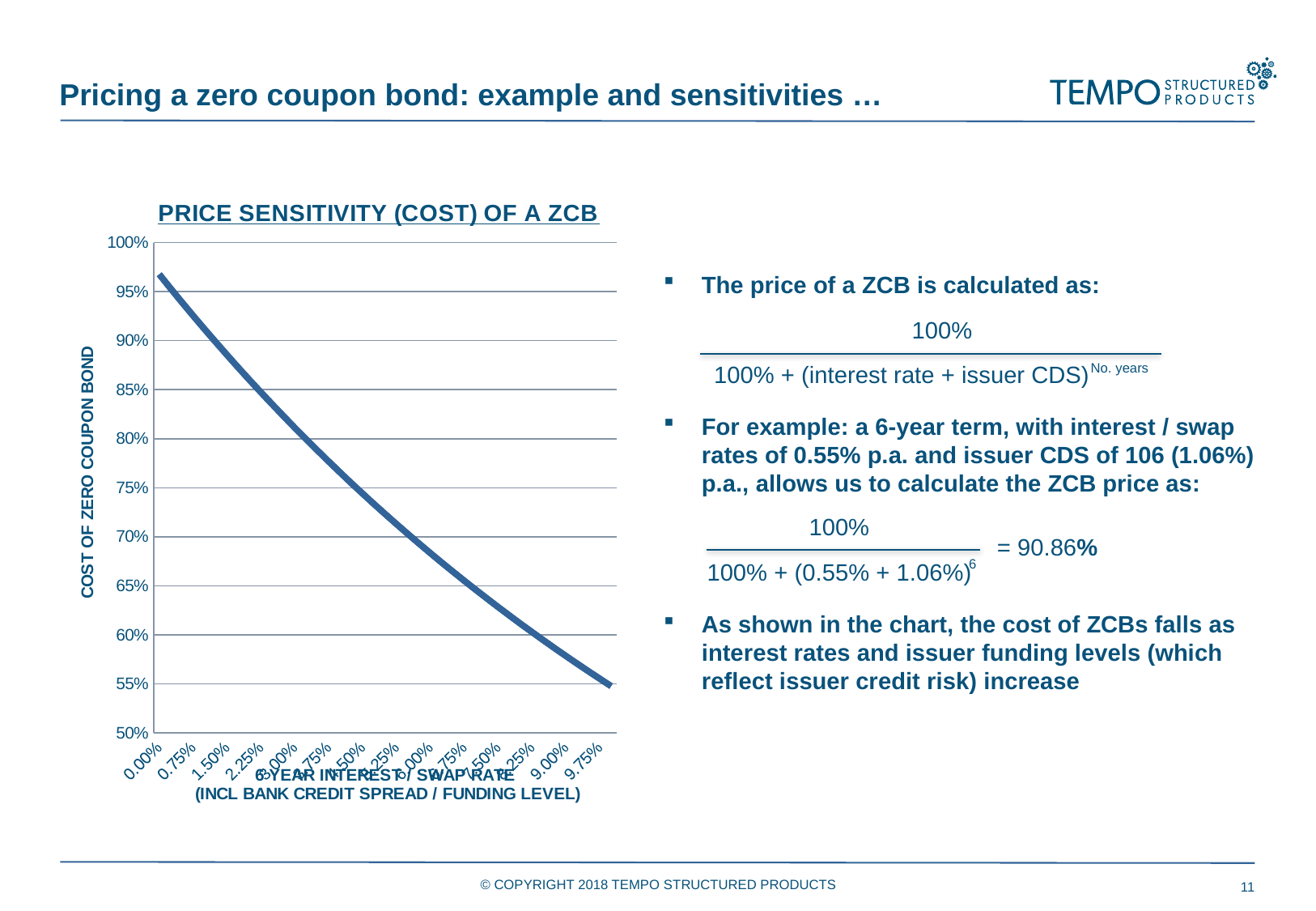
Is the cost of the zero coupon bond at a 9.75% interest / swap rate greater or less than 60%? less Is the cost of the zero coupon bond at a 2.25% interest / swap rate greater or less than 80%? greater What is the label of the vertical axis of the chart? COST OF ZERO COUPON BOND Does the cost of the zero coupon bond rise or fall as the 6-year interest / swap rate increases along the x axis? fall Is the cost of the zero coupon bond at a 0.00% interest / swap rate greater or less than 95%? greater What kind of chart is shown on the slide? line chart At which interest / swap rate on the x axis is the cost of the zero coupon bond highest? 0.00% Which has the larger cost of zero coupon bond: an interest / swap rate of 0.75% or 9.00%? 0.75% What is the title of the chart? PRICE SENSITIVITY (COST) OF A ZCB How many interest / swap rate labels are shown on the x axis? 14 At which interest / swap rate on the x axis is the cost of the zero coupon bond lowest? 9.75%